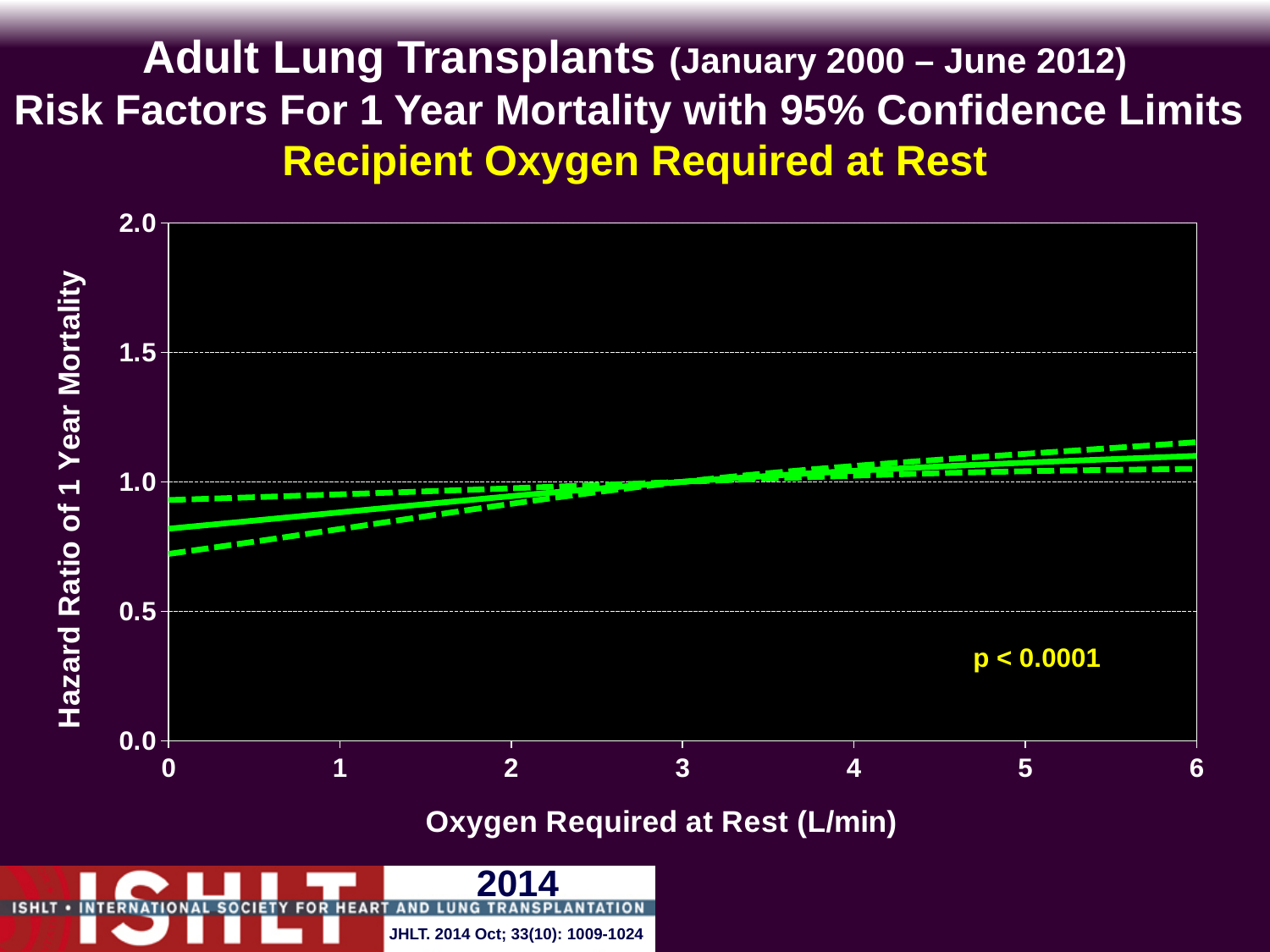
What kind of chart is shown on the slide? line chart How many lines are plotted on the chart? 3 What is the highest value shown on the x axis? 6 At 0 L/min, is the lower dashed confidence limit greater or less than 0.5? greater What is the label of the x axis? Oxygen Required at Rest (L/min) What is the highest value shown on the y axis? 2.0 At 6 L/min, is the upper dashed confidence limit greater or less than 1.5? less At 6 L/min, is the solid hazard ratio line greater or less than 1.0? greater What is the label of the y axis? Hazard Ratio of 1 Year Mortality What p-value is printed on the chart? p < 0.0001 Does the solid hazard ratio line rise or fall as oxygen required at rest increases from 0 to 6 L/min? rise